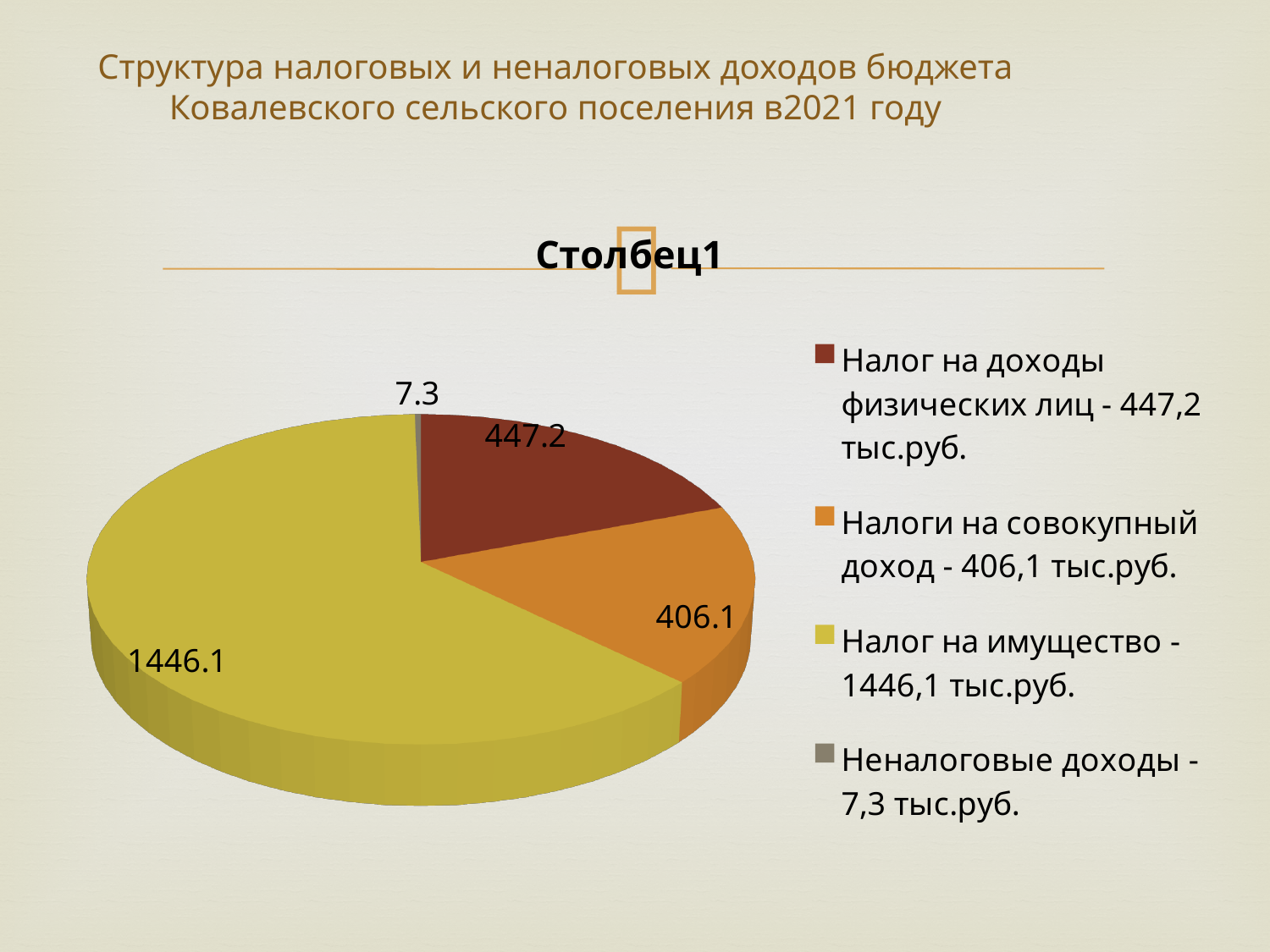
Which category has the largest slice of the pie? Налог на имущество What value is shown for Налог на имущество? 1446.1 What kind of chart is shown on the slide? pie chart What is the total of all four slices in the pie chart? 2306.7 What value is shown for Неналоговые доходы? 7.3 What is the chart's title? Столбец1 Which category has the smallest slice of the pie? Неналоговые доходы Which is larger: Налог на имущество or Налоги на совокупный доход? Налог на имущество What value is shown for Налог на доходы физических лиц? 447.2 Which colour represents Налоги на совокупный доход in the legend? orange What is the difference between the values for Налог на доходы физических лиц and Налоги на совокупный доход? 41.1 How many slices does the pie chart have? 4